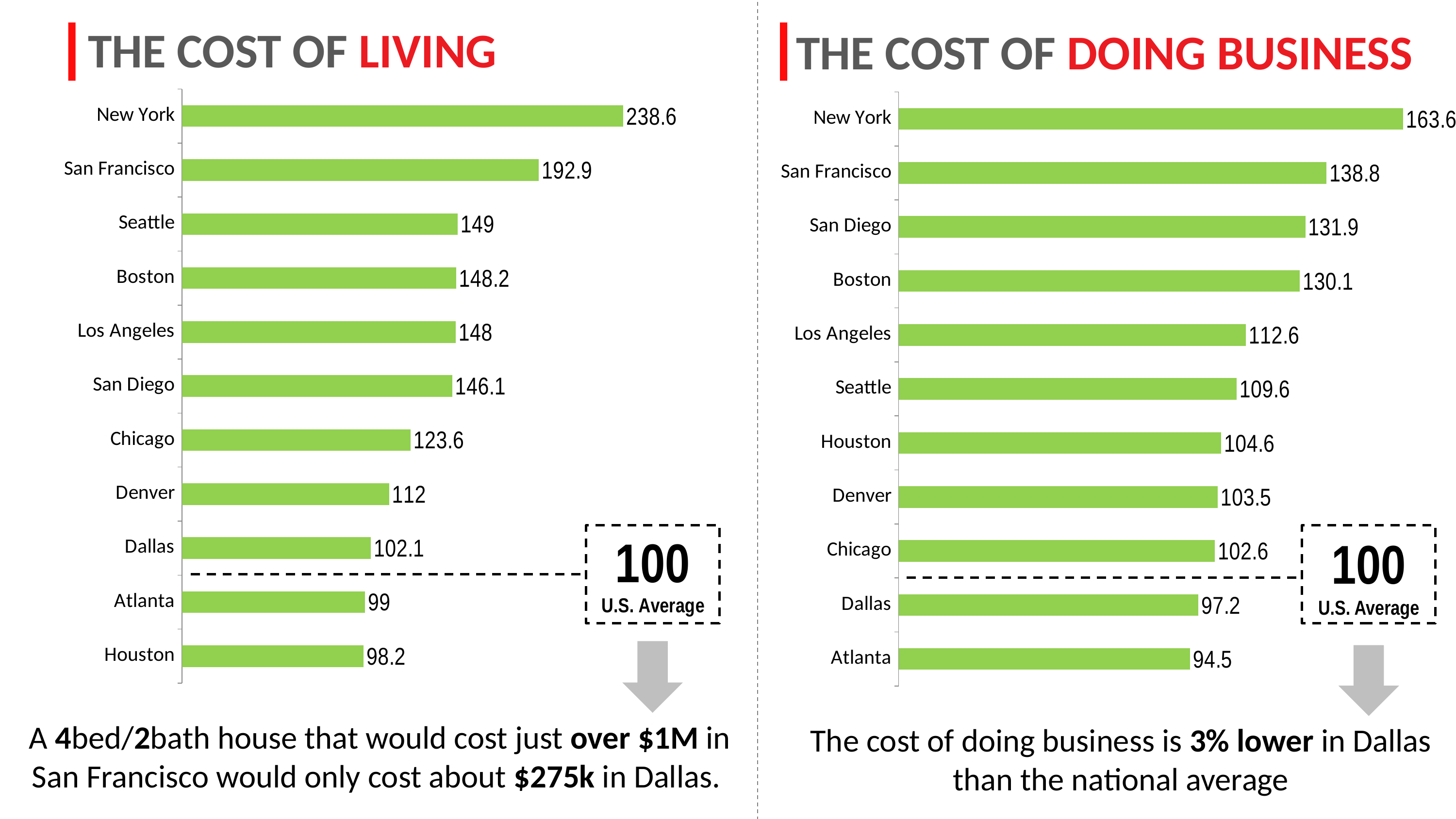
In the Cost of Living chart, what is the difference between New York and Dallas? 136.5 In the Cost of Living chart, which city has the highest value? New York In the Cost of Living chart, what is the value for San Francisco? 192.9 In the Cost of Living chart, which city has the lowest value? Houston In the Cost of Doing Business chart, how many cities are shown? 11 In the Cost of Doing Business chart, which city has the lowest value? Atlanta In the Cost of Doing Business chart, what is the value for Dallas? 97.2 In the Cost of Living chart, how many cities are shown? 11 In the Cost of Doing Business chart, what is the difference between New York and San Francisco? 24.8 In the Cost of Doing Business chart, which is larger, San Diego or Los Angeles? San Diego What type of chart is the Cost of Living chart? Bar chart What value is marked as the U.S. Average by the dashed line in both charts? 100